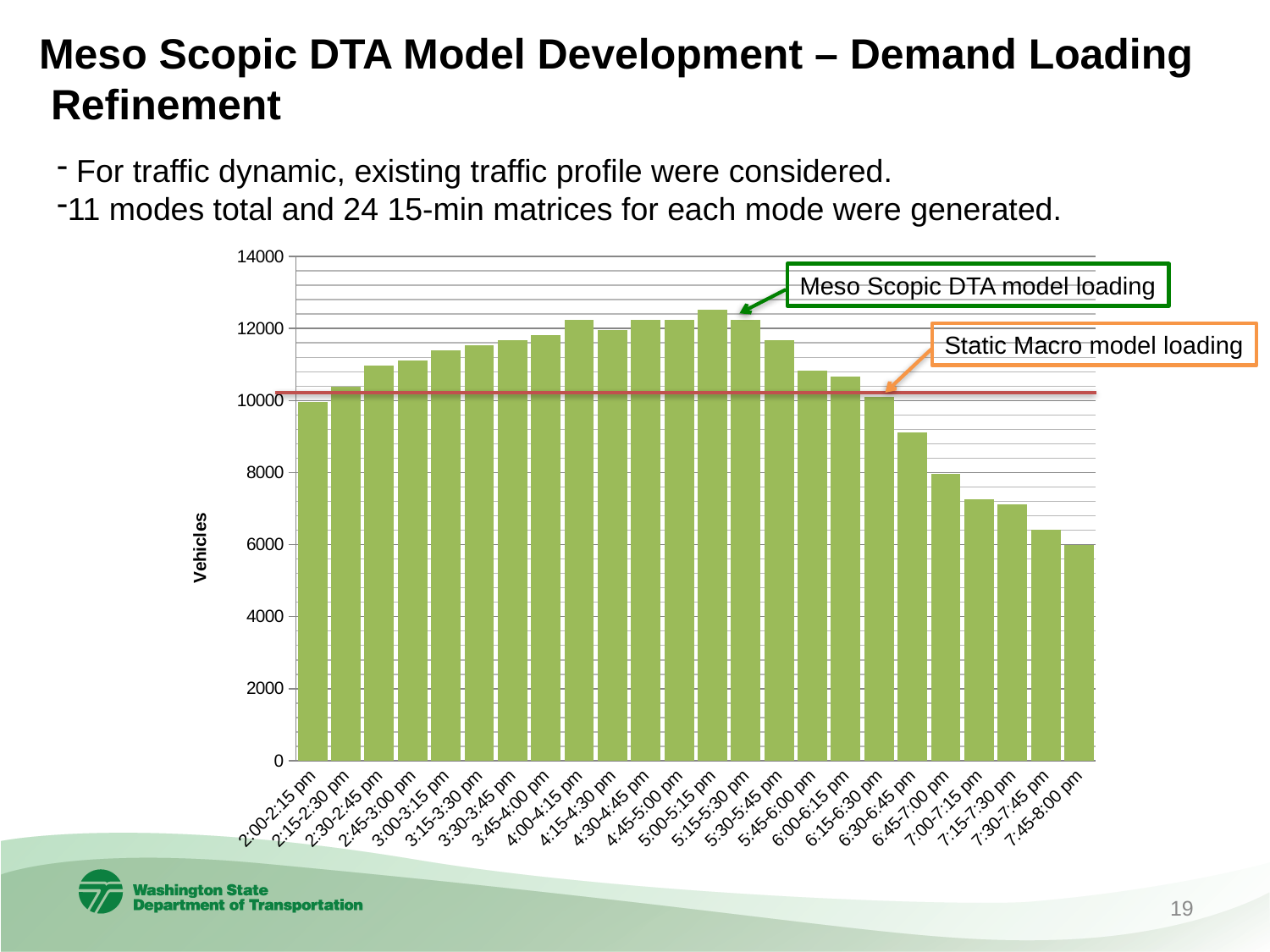
Which time interval has the lowest number of vehicles? 7:45-8:00 pm What is the label on the vertical axis of the chart? Vehicles Is the value for 7:15-7:30 pm greater or less than 8000? less What kind of chart is shown on the slide? bar chart Do the values rise or fall from 5:15-5:30 pm to 7:45-8:00 pm? fall Is the value for 6:45-7:00 pm greater or less than 10000? less Is the value for 3:00-3:15 pm greater or less than 10000? greater What does the horizontal red line across the chart represent? Static Macro model loading Which has more vehicles, 5:00-5:15 pm or 7:45-8:00 pm? 5:00-5:15 pm Which time interval has the highest number of vehicles? 5:00-5:15 pm How many time-interval bars are plotted in the chart? 24